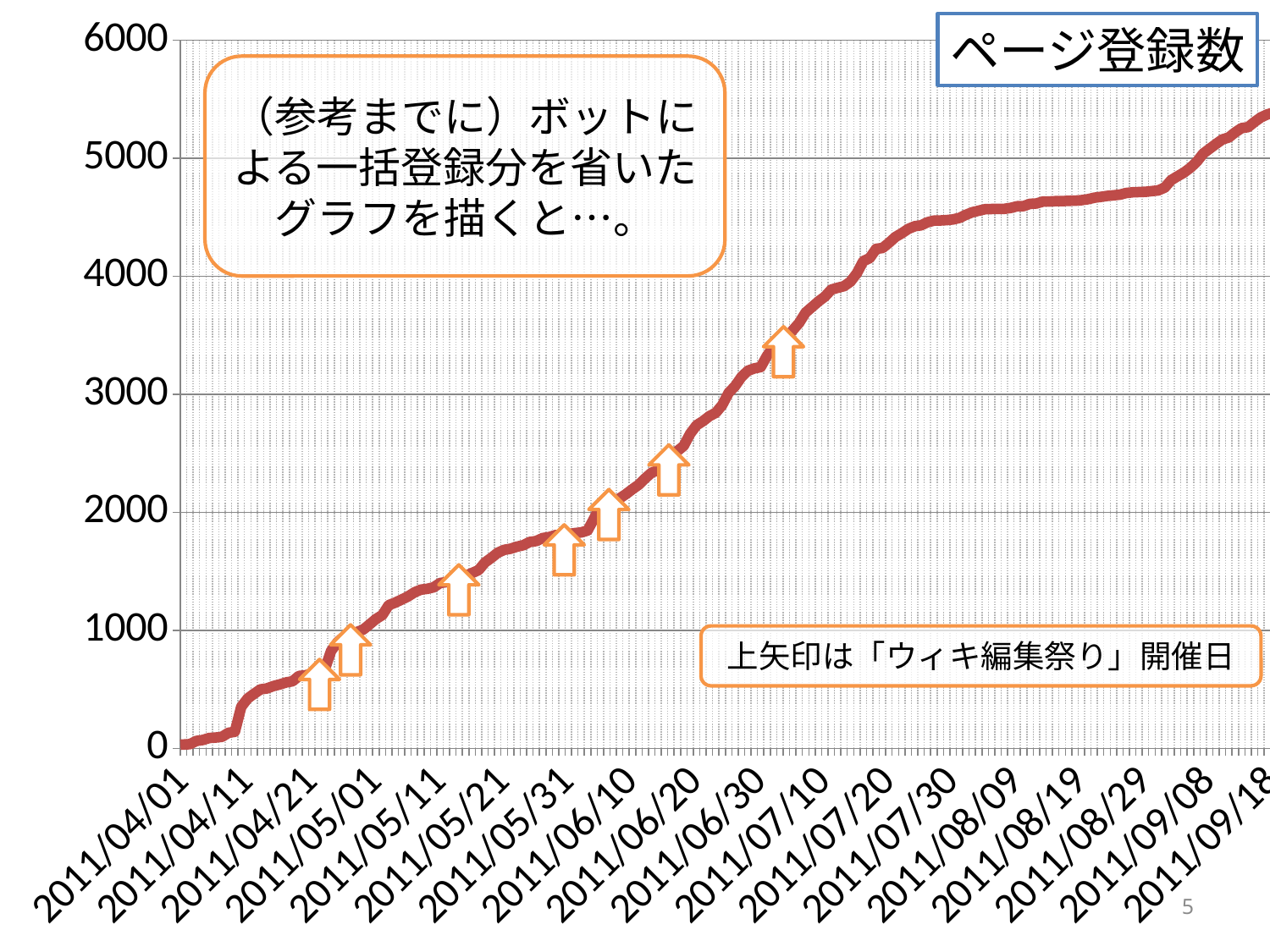
What kind of chart is shown on the slide? line chart According to the note on the slide, what do the upward arrows on the chart mark? 「ウィキ編集祭り」開催日 What is the title of the chart? ページ登録数 Is the value at 2011/07/20 greater or less than 4000? greater Which is larger, the value at 2011/07/20 or the value at 2011/05/21? 2011/07/20 How many date labels are shown on the x axis? 18 Is the value at 2011/05/31 greater or less than 2000? less Is the value at 2011/09/18 greater or less than 5000? greater At which labelled date on the x axis is the value highest? 2011/09/18 Do the values rise or fall along the x axis from 2011/04/01 to 2011/09/18? rise